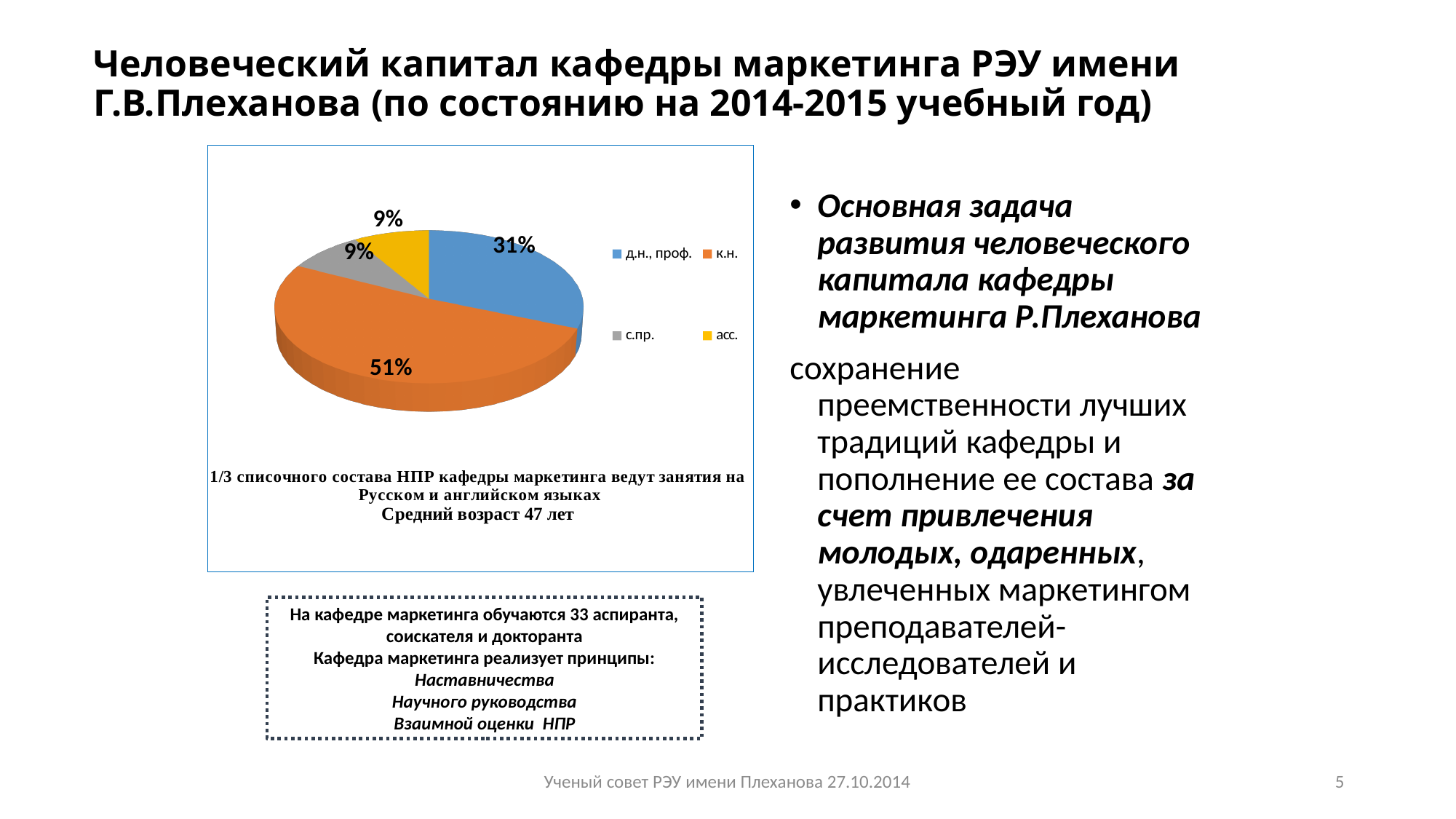
Which slice is larger, "д.н., проф." or "к.н."? к.н. What colour is the "к.н." slice in the pie chart? orange How many entries does the chart legend list? 4 What share of the pie does the "д.н., проф." slice represent? 31% What kind of chart is shown on the slide? pie chart How many slices does the pie chart have? 4 What is the difference in percentage points between the "к.н." slice and the "д.н., проф." slice? 20 What share of the pie does the "к.н." slice represent? 51% Which category has the largest slice of the pie? к.н. What share of the pie does the "с.пр." slice represent? 9% What is the difference in percentage points between the "д.н., проф." slice and the "с.пр." slice? 22